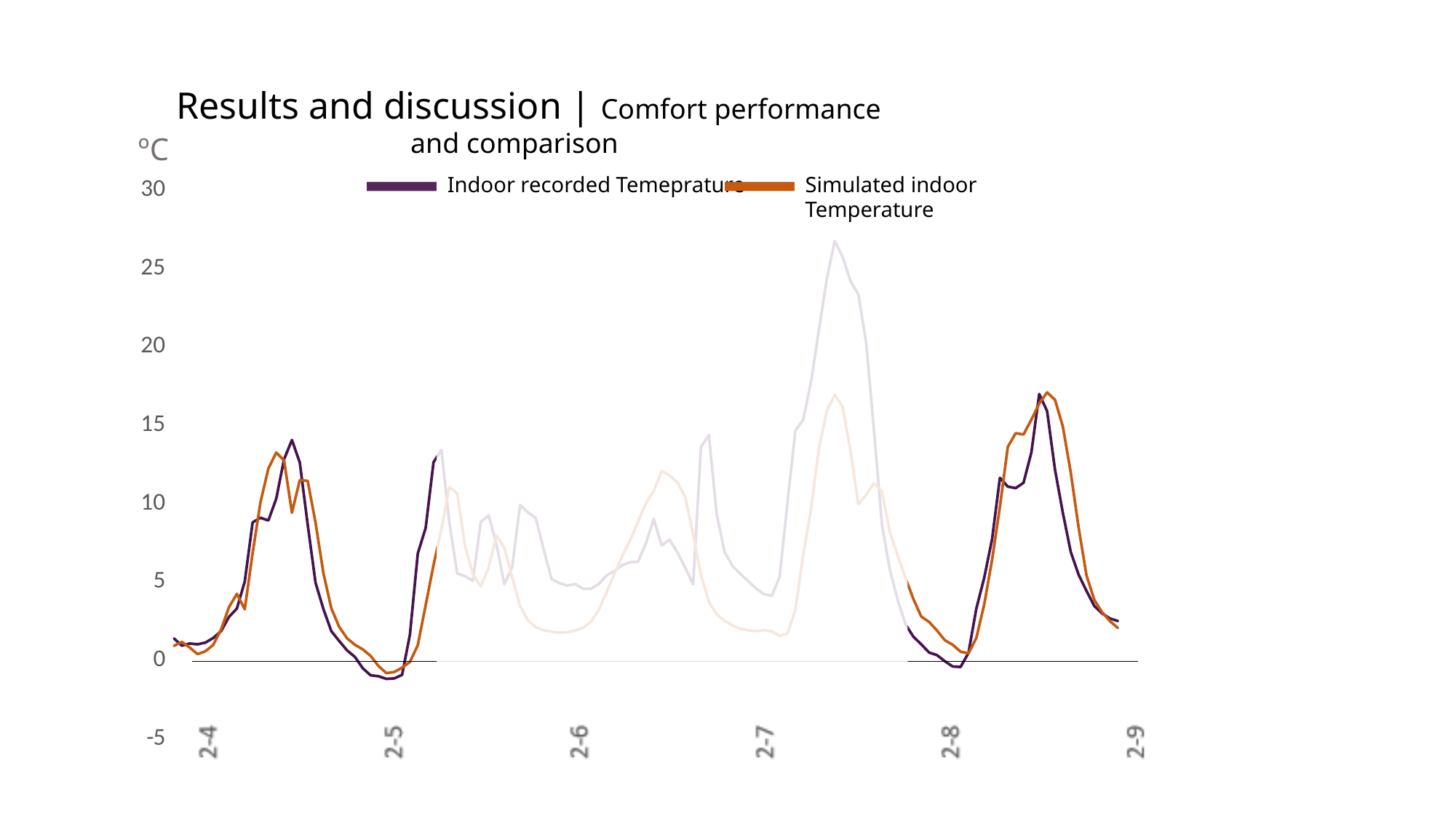
What is the highest value labelled on the vertical axis? 30 How many date labels are shown along the x axis? 6 Is the peak of the Indoor recorded Temeprature series between 2-8 and 2-9 greater or less than 15? greater How many series does the legend list? 2 What kind of chart is shown on the slide? line chart Is the peak of the Simulated indoor Temperature series just after 2-7 greater or less than 20? less At the peak just after 2-7, which series reaches the higher value, Indoor recorded Temeprature or Simulated indoor Temperature? Indoor recorded Temeprature Is the highest peak of the Indoor recorded Temeprature series, just after 2-7, greater or less than 25? greater What are the two series named in the legend? Indoor recorded Temeprature and Simulated indoor Temperature What is the lowest value labelled on the vertical axis? -5 What unit is shown at the top of the vertical axis? °C